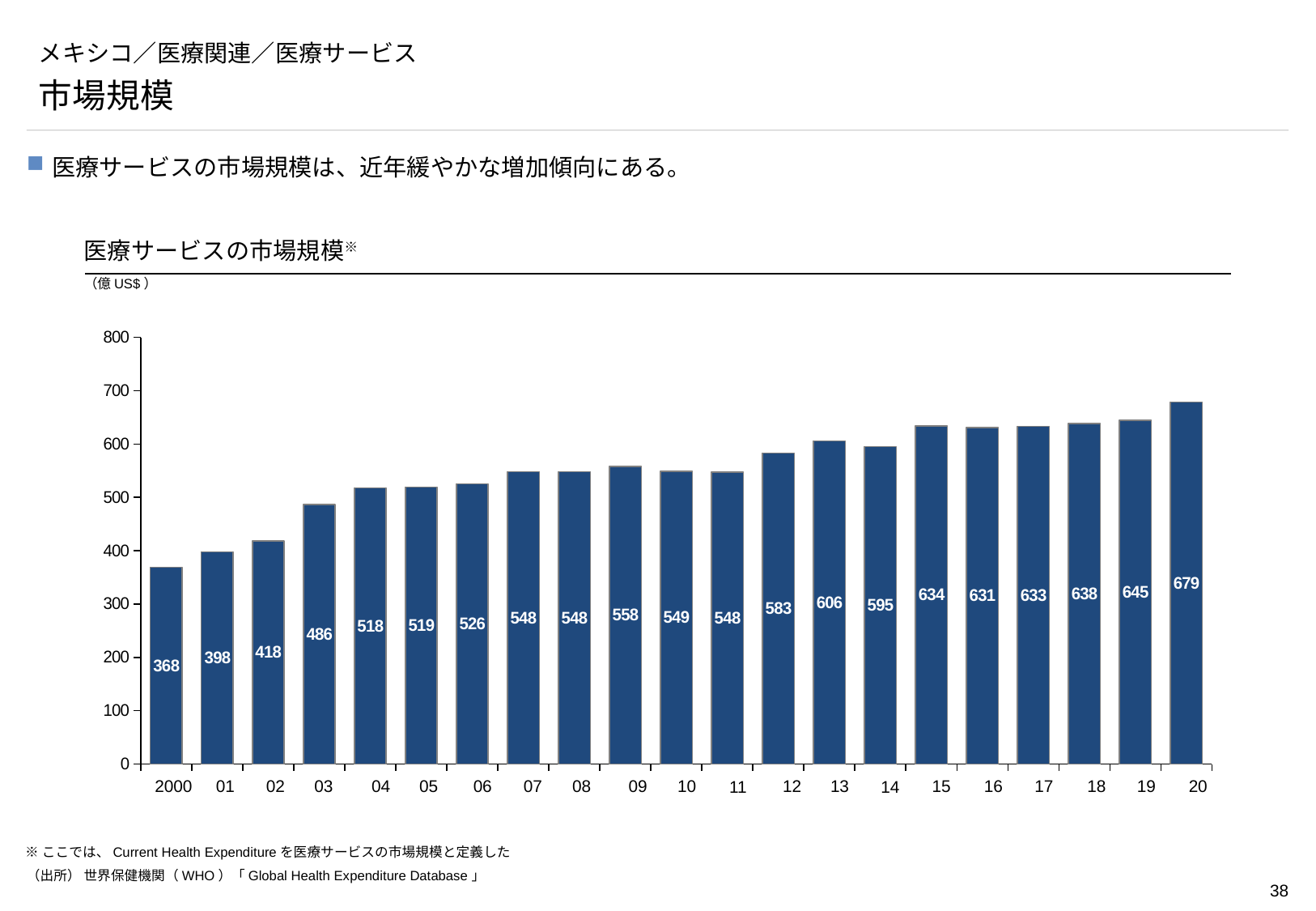
What kind of chart is this? bar chart Which is larger, the value for 09 or the value for 10? 09 Which year has the highest value? 20 How many years are shown on the x axis? 21 What is the difference between the values for 20 and 2000? 311 Which year has the lowest value? 2000 What is the value for 13? 606 What is the difference between the values for 13 and 14? 11 Do the values generally rise or fall from 2000 to 20? rise What is the value for 20? 679 What is the value for 2000? 368 Is the value for 03 greater or less than 500? less